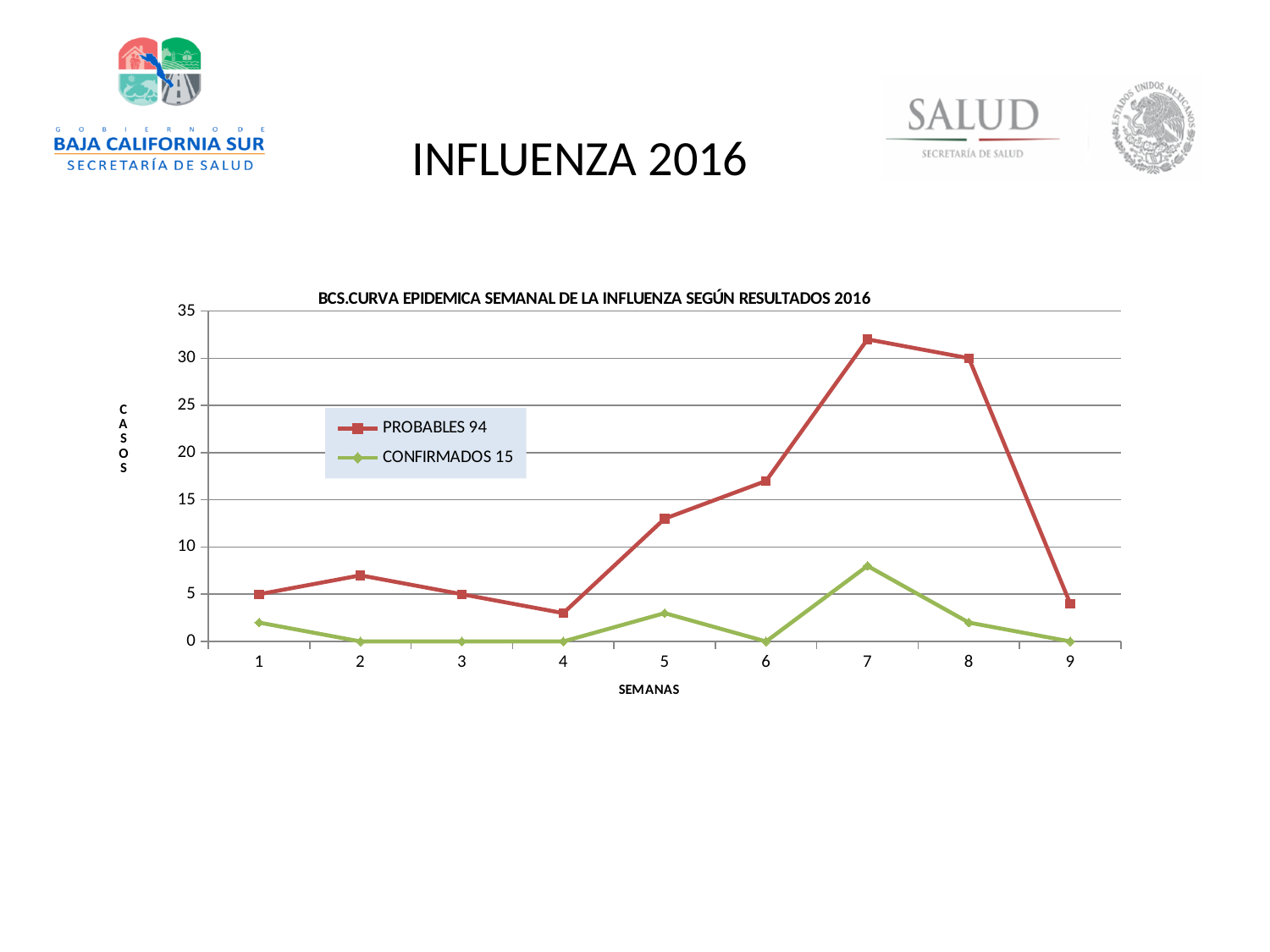
Is the value for PROBABLES 94 in week 5 greater or less than 10? greater Does PROBABLES 94 rise or fall from week 8 to week 9? fall Which series has the larger value in week 6, PROBABLES 94 or CONFIRMADOS 15? PROBABLES 94 Is the value for PROBABLES 94 in week 7 greater or less than 30? greater In which week does CONFIRMADOS 15 reach its highest value? 7 What kind of chart is shown on the slide? line chart What is the value of PROBABLES 94 in week 1? 5 How many series does the legend list? 2 In which week does PROBABLES 94 reach its highest value? 7 How many weeks (SEMANAS) are plotted on the x axis? 9 What is the value of CONFIRMADOS 15 in week 4? 0 What is the value of PROBABLES 94 in week 8? 30